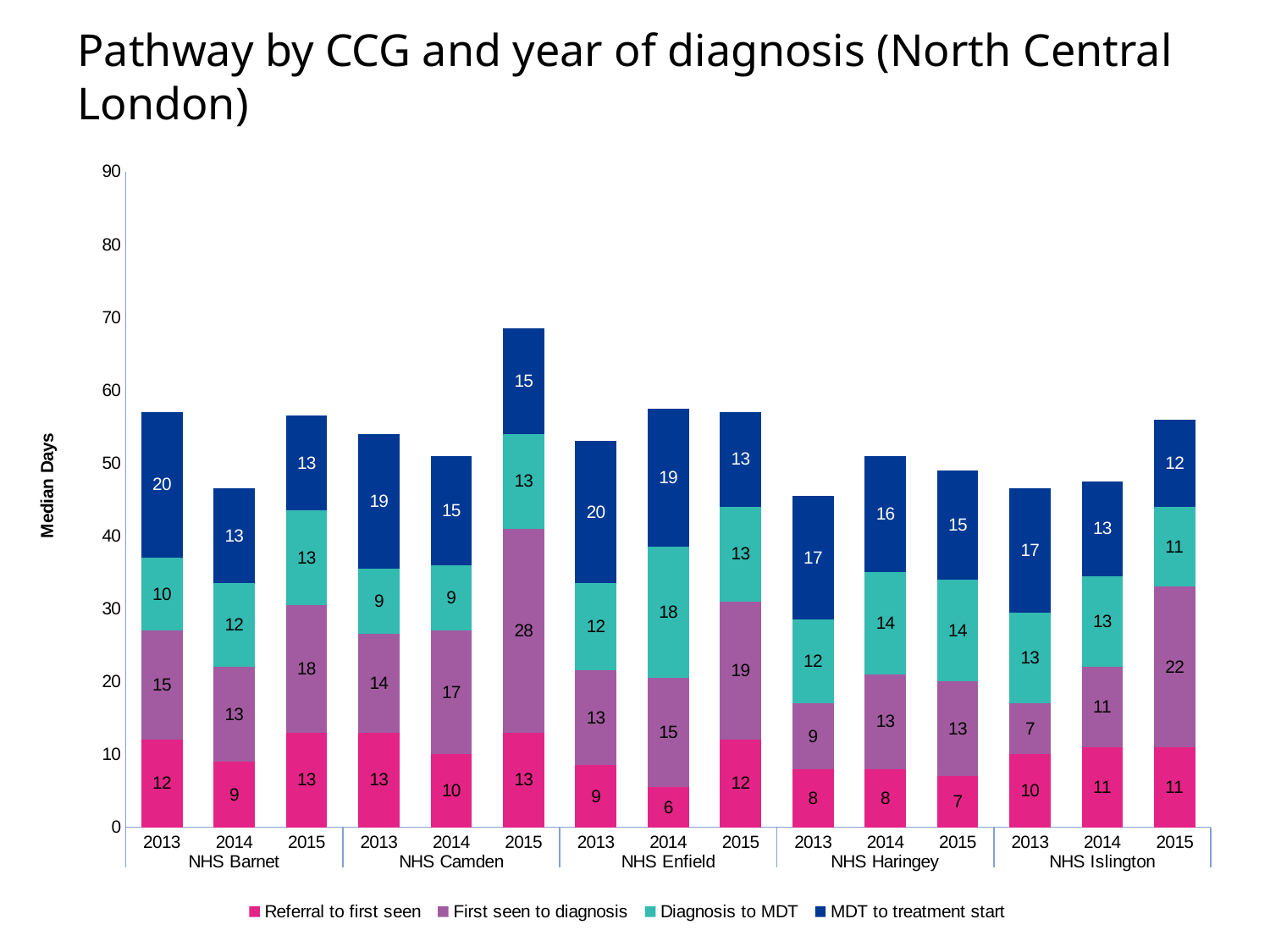
Which CCG and year has the lowest Referral to first seen value? NHS Enfield 2014 What is the label on the y axis? Median Days What is the difference between the Diagnosis to MDT value for NHS Enfield 2014 and NHS Barnet 2013? 8 What is the First seen to diagnosis value for NHS Camden in 2015? 28 How many CCGs are shown on the x axis? 5 What is the total of the stacked bar for NHS Islington 2015? 56 What kind of chart is shown on the slide? Stacked bar chart Which CCG and year has the tallest stacked bar overall? NHS Camden 2015 How many series does the legend list? 4 Is the total height of the NHS Camden 2015 bar greater or less than 60? greater What is the MDT to treatment start value for NHS Barnet in 2013? 20 Which is larger: the MDT to treatment start value for NHS Haringey 2013 or for NHS Islington 2015? NHS Haringey 2013